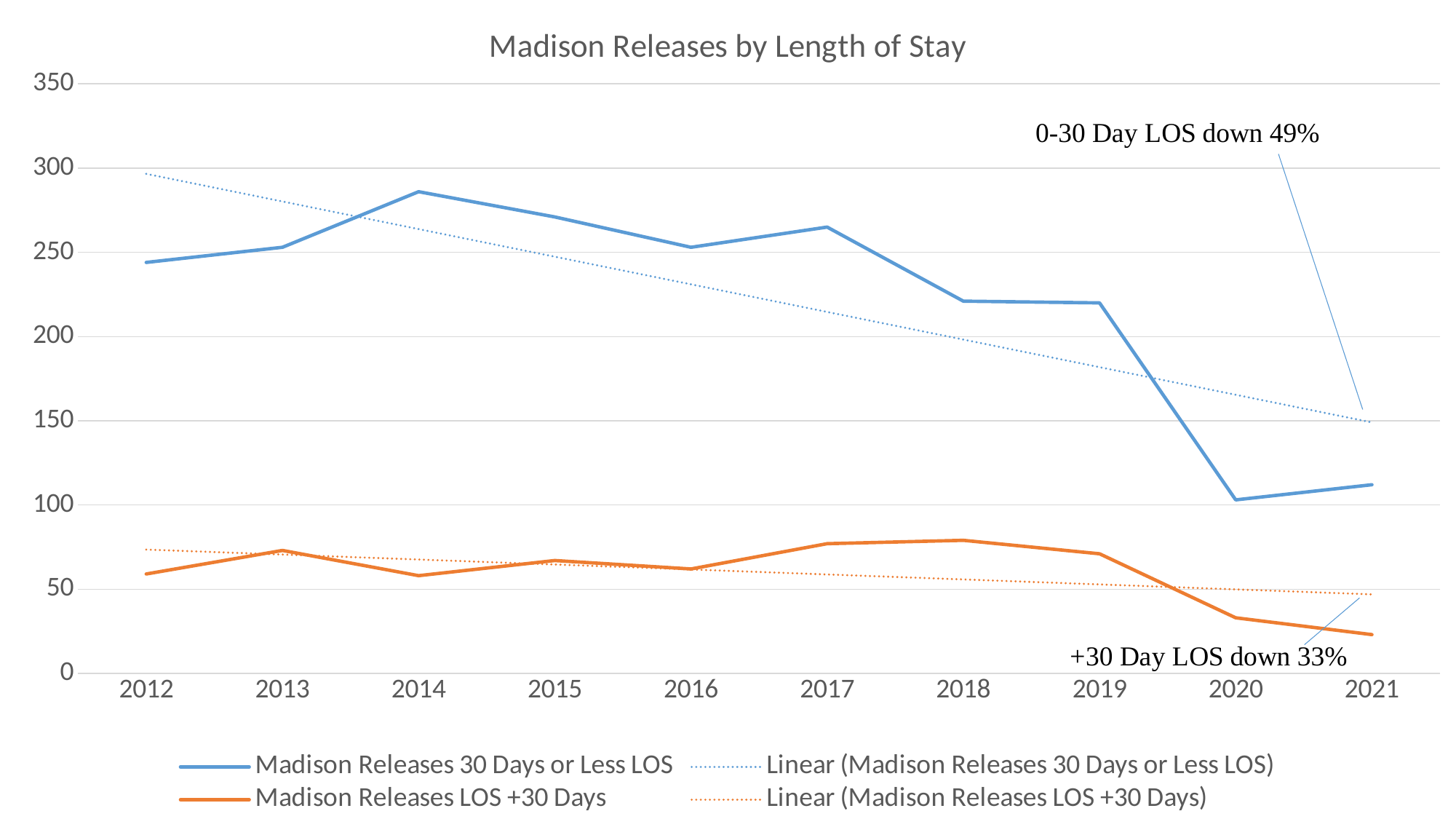
What type of chart is shown on the slide? line chart Overall, does the Madison Releases 30 Days or Less LOS line rise or fall from 2012 to 2021? fall Is the value for Madison Releases 30 Days or Less LOS in 2014 greater or less than 250? greater Is the value for Madison Releases 30 Days or Less LOS in 2020 greater or less than 150? less In which year is the value for Madison Releases LOS +30 Days lowest? 2021 Which series has the larger value in 2018, Madison Releases 30 Days or Less LOS or Madison Releases LOS +30 Days? Madison Releases 30 Days or Less LOS Is the value for Madison Releases LOS +30 Days in 2021 greater or less than 50? less How many entries does the legend list? 4 What is the title of the chart? Madison Releases by Length of Stay In which year is the value for Madison Releases 30 Days or Less LOS lowest? 2020 In which year is the value for Madison Releases 30 Days or Less LOS highest? 2014 How many years are shown on the x axis? 10